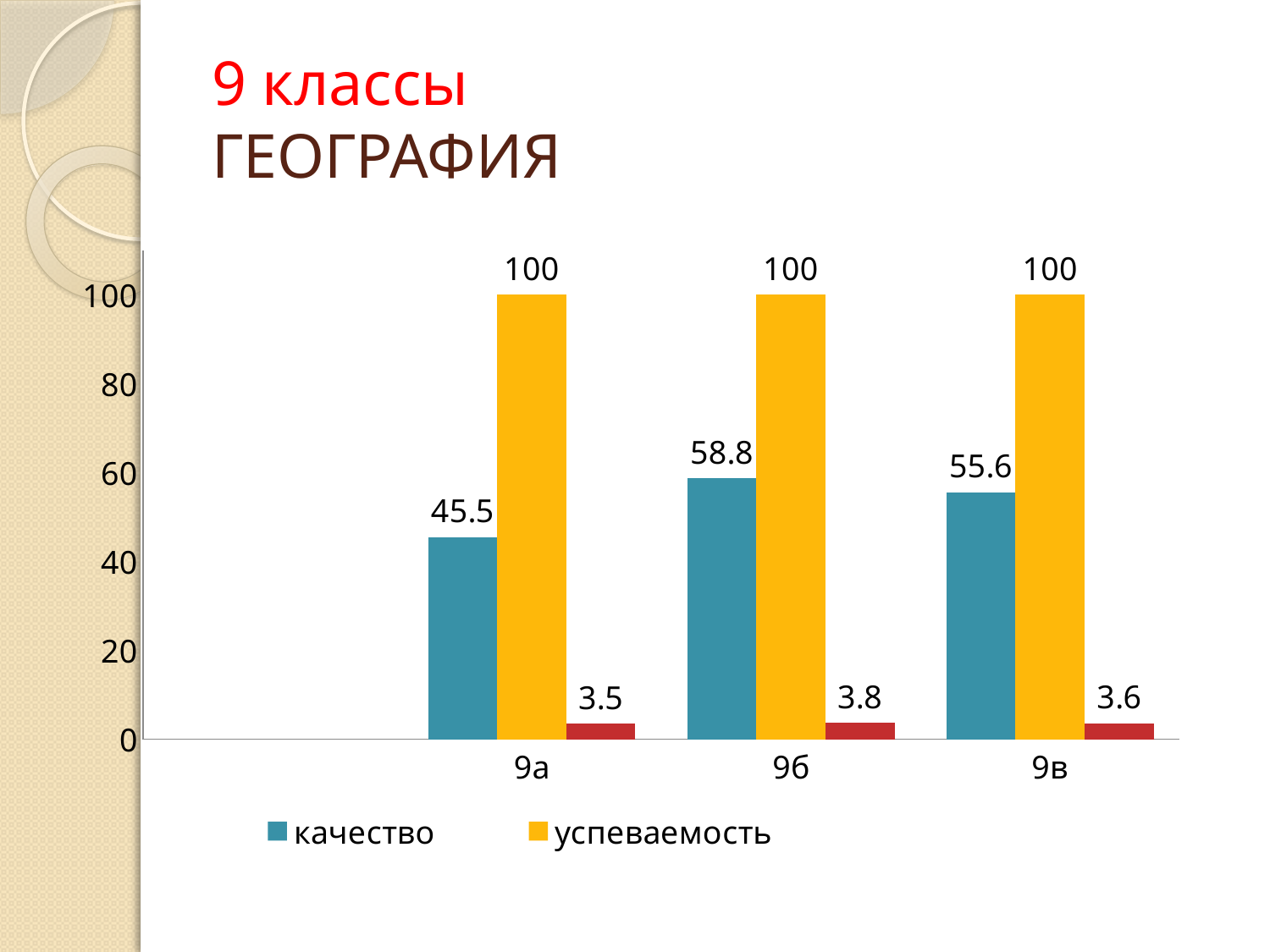
What is the успеваемость value for class 9в? 100 Which class has the highest качество value? 9б What is the value of the red bar for class 9б? 3.8 What is the difference between the качество values for 9б and 9а? 13.3 How many series does the legend list? 2 What is the качество value for class 9б? 58.8 How many classes are shown on the x axis? 3 What is the качество value for class 9а? 45.5 Which is larger, the качество value for 9в or for 9а? 9в Which class has the lowest качество value? 9а Which colour represents the успеваемость series? yellow What kind of chart is shown on the slide? bar chart